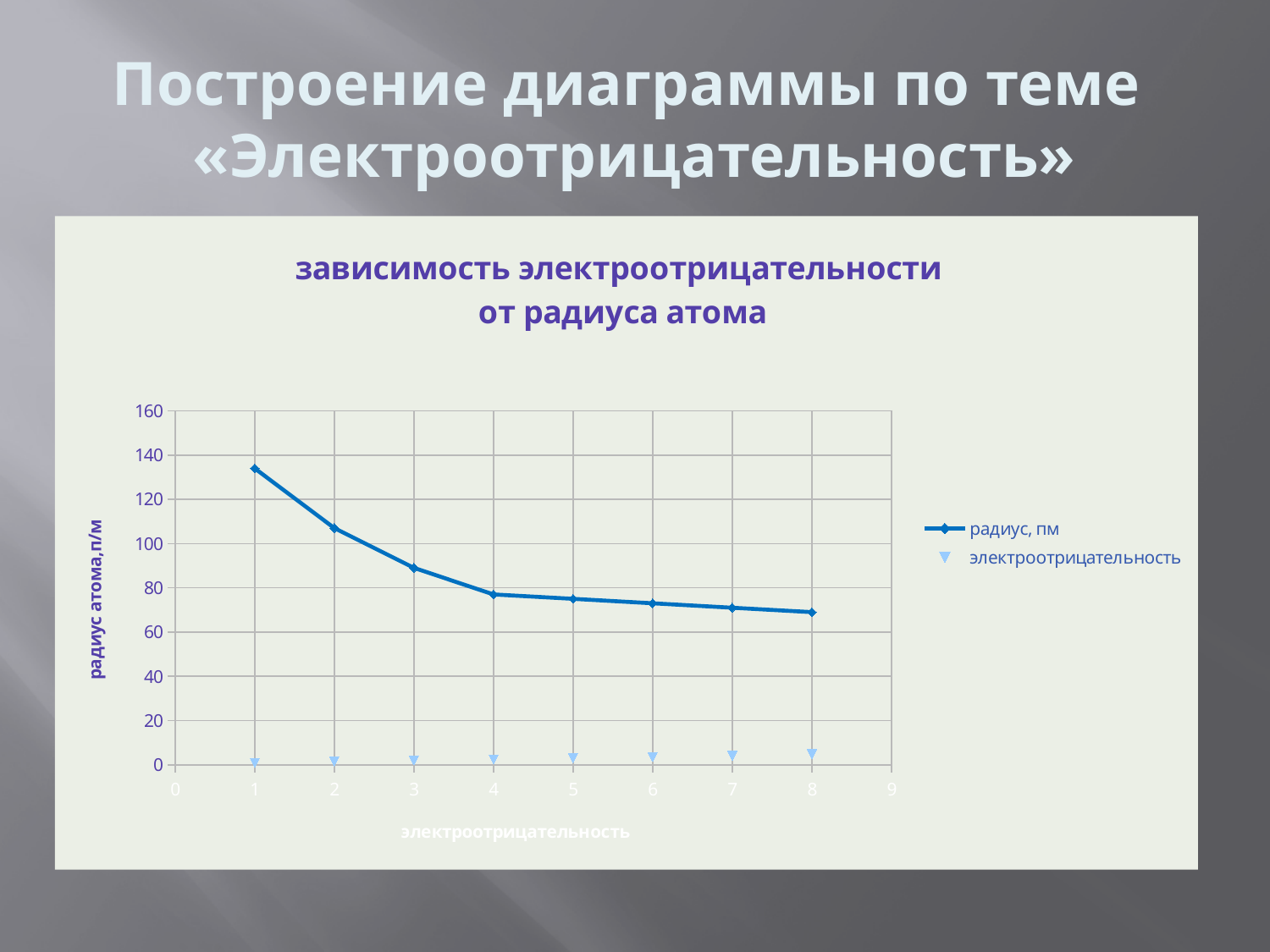
Do the values of the series "радиус, пм" rise or fall as the x axis increases? fall Is the value of "радиус, пм" at x = 8 greater or less than 80? less What is the title of the chart? зависимость электроотрицательности от радиуса атома At which x value is the series "радиус, пм" highest? 1 Is the value of "радиус, пм" at x = 2 greater or less than 100? greater How many series does the legend list? 2 How many data points are plotted for the series "радиус, пм"? 8 Is the value of "радиус, пм" at x = 1 greater or less than 120? greater What kind of chart is shown on the slide? line chart What is the label of the vertical axis? радиус атома,п/м Which is larger for the series "радиус, пм": the value at x = 1 or the value at x = 8? x = 1